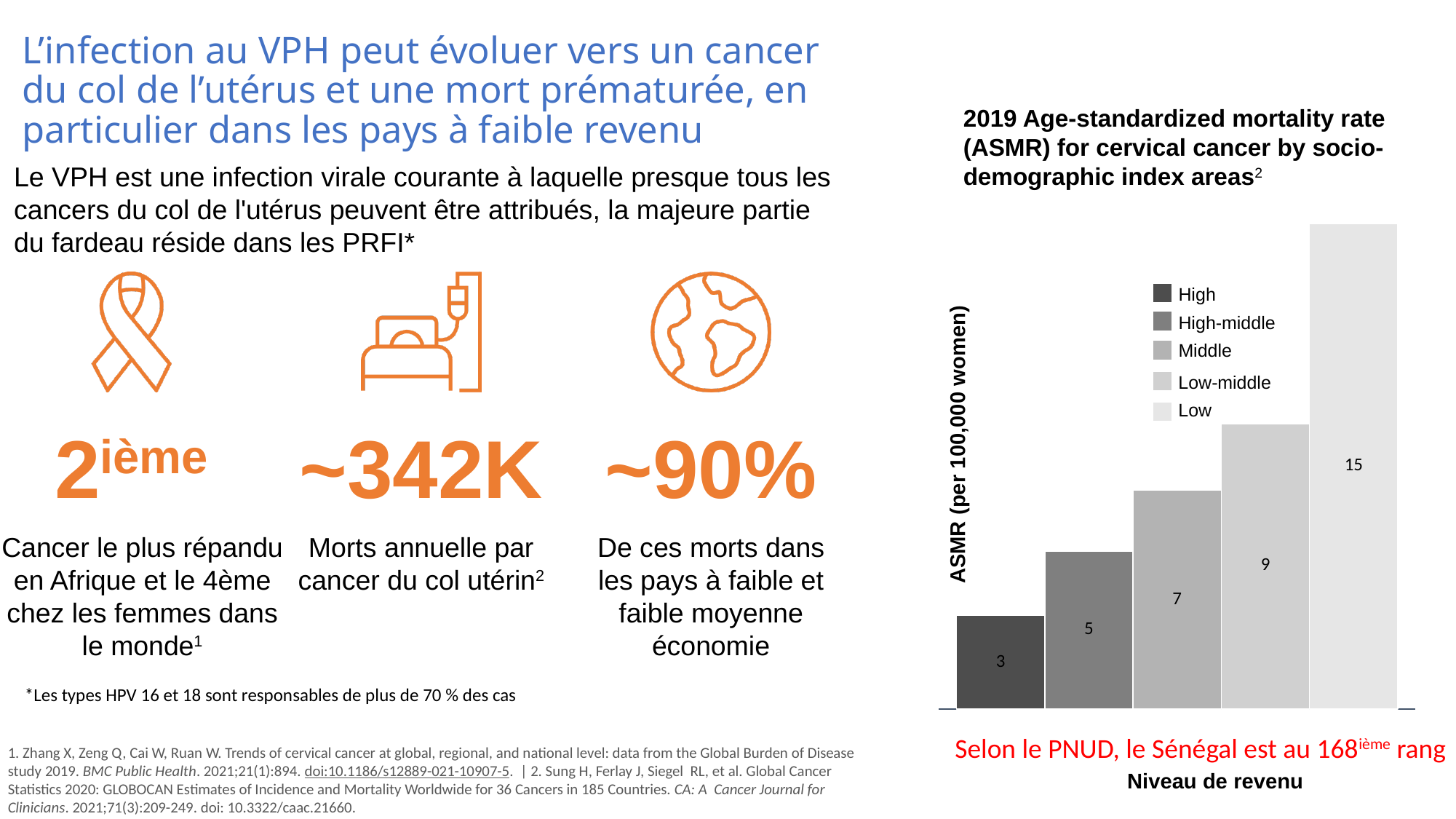
What is the ASMR value for the Low income group? 15 Which has a higher ASMR, the Middle or the High-middle income group? Middle Which income group has the highest ASMR? Low Which income group has the lowest ASMR? High What type of chart is shown on the slide? Bar chart What is the label of the y axis of the chart? ASMR (per 100,000 women) What is the ASMR value for the High income group? 3 What is the difference in ASMR between the Low and High income groups? 12 What is the ASMR value for the Middle income group? 7 Do the ASMR values rise or fall as income level goes from High to Low? Rise What is the difference in ASMR between the Low-middle and High-middle income groups? 4 How many income groups are shown in the chart? 5